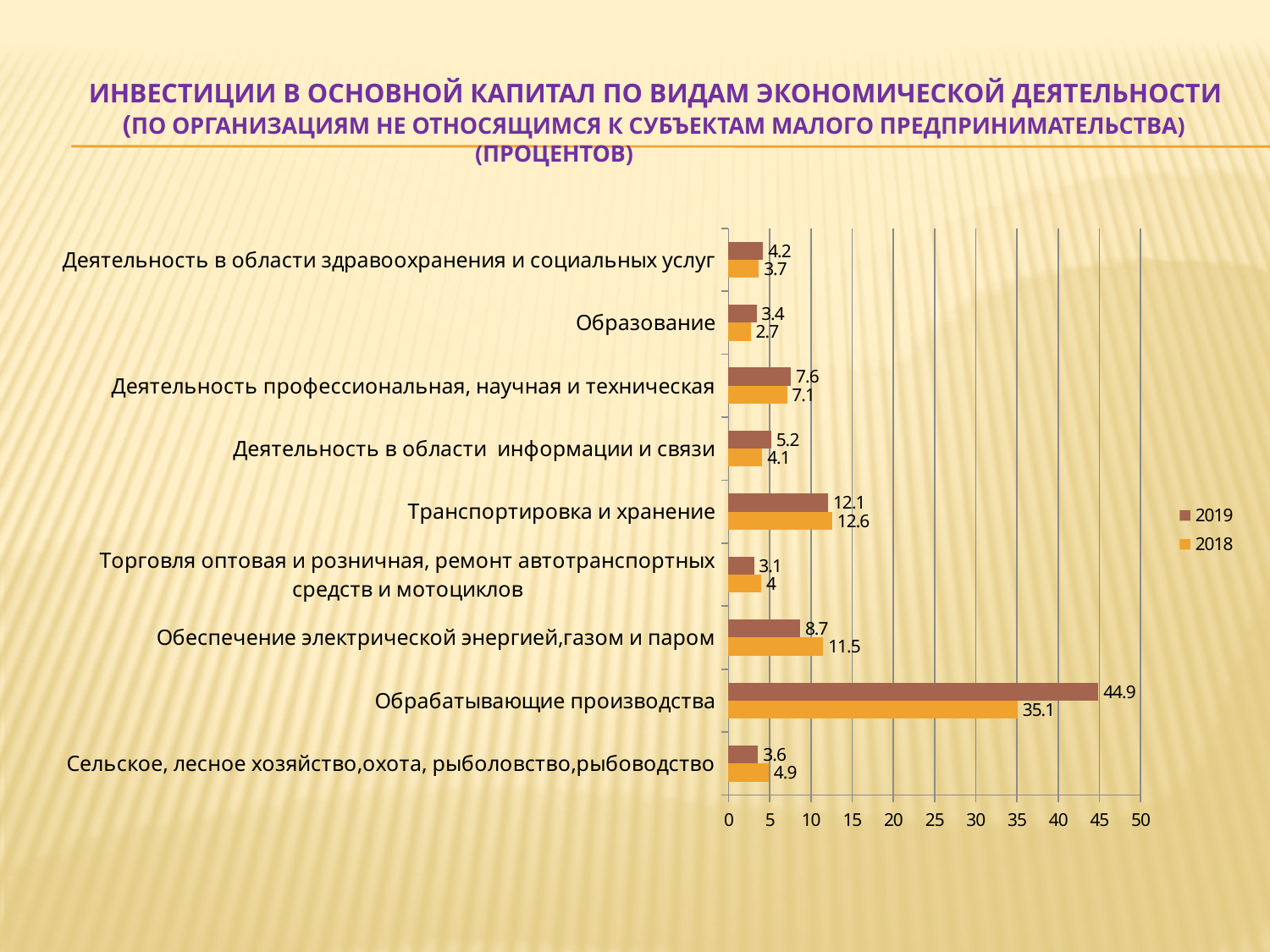
Which category has the highest 2019 value? Обрабатывающие производства Which legend entry is shown in orange? 2018 What is the 2019 value for Обрабатывающие производства? 44.9 Which is larger for Сельское, лесное хозяйство, охота, рыболовство, рыбоводство: the 2019 value or the 2018 value? 2018 What is the 2018 value for Обеспечение электрической энергией, газом и паром? 11.5 What is the difference between the 2019 and 2018 values for Обрабатывающие производства? 9.8 Which category has the lowest 2018 value? Образование What kind of chart is shown on the slide? bar chart What is the 2018 value for Транспортировка и хранение? 12.6 How many series does the legend list? 2 How many categories are shown on the chart? 9 Is the 2018 value for Обрабатывающие производства greater or less than 30? greater